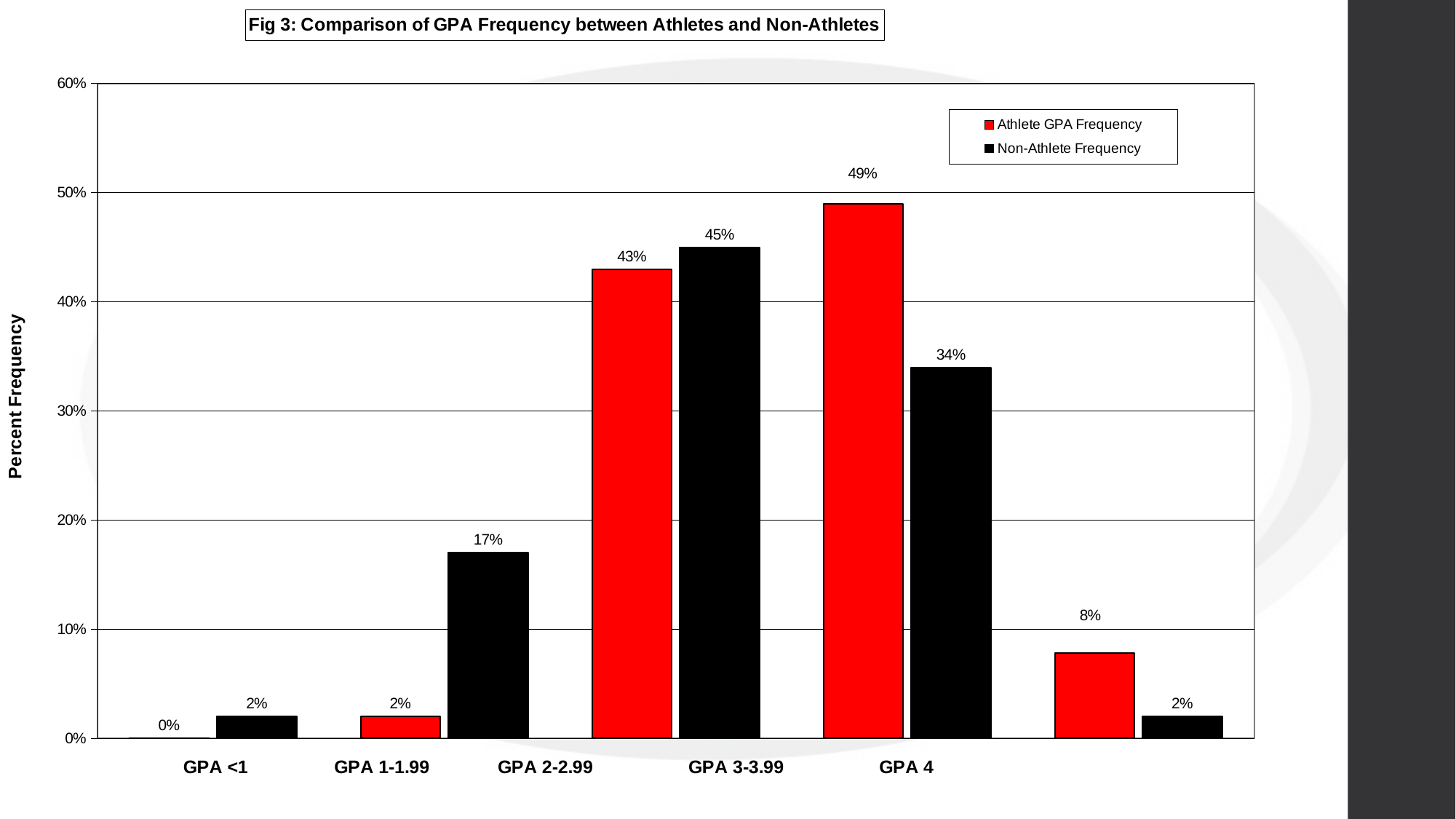
How many series does the legend list? 2 What is the Athlete GPA Frequency for GPA 4? 8% Is the Non-Athlete Frequency for GPA 4 greater or less than 10%? less How many GPA categories are shown on the x axis? 5 What type of chart is shown on the slide? Bar chart Which GPA category has the lowest Athlete GPA Frequency? GPA <1 What is the Non-Athlete Frequency for GPA 1-1.99? 17% What is the Non-Athlete Frequency for GPA 2-2.99? 45% What is the Athlete GPA Frequency for GPA 3-3.99? 49% What is the difference between the Athlete GPA Frequency and the Non-Athlete Frequency for GPA 3-3.99? 15% Which GPA category has the highest Athlete GPA Frequency? GPA 3-3.99 For GPA 1-1.99, which is larger: the Athlete GPA Frequency or the Non-Athlete Frequency? Non-Athlete Frequency